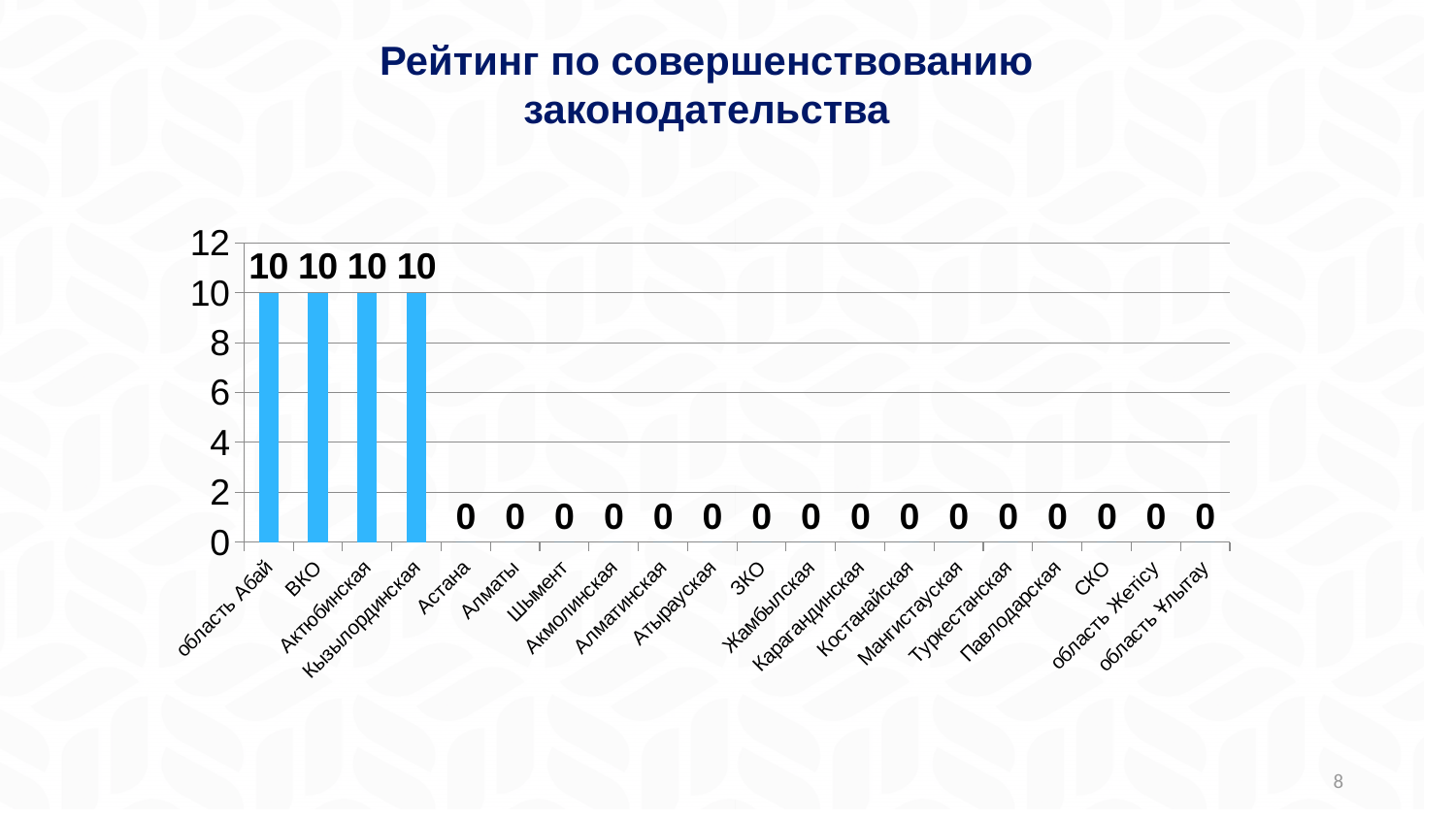
What is the title of the slide? Рейтинг по совершенствованию законодательства What is the value for Кызылординская? 10 What is the value for Павлодарская? 0 What kind of chart is shown on the slide? bar chart What is the value for ВКО? 10 Is the value for Актюбинская greater or less than 8? greater What is the highest value shown on the y axis? 12 Which is larger, the value for область Абай or the value for СКО? область Абай How many categories have a value of 10? 4 What is the difference between the values for Актюбинская and Алматы? 10 What is the value for Астана? 0 How many categories are shown on the x axis? 20